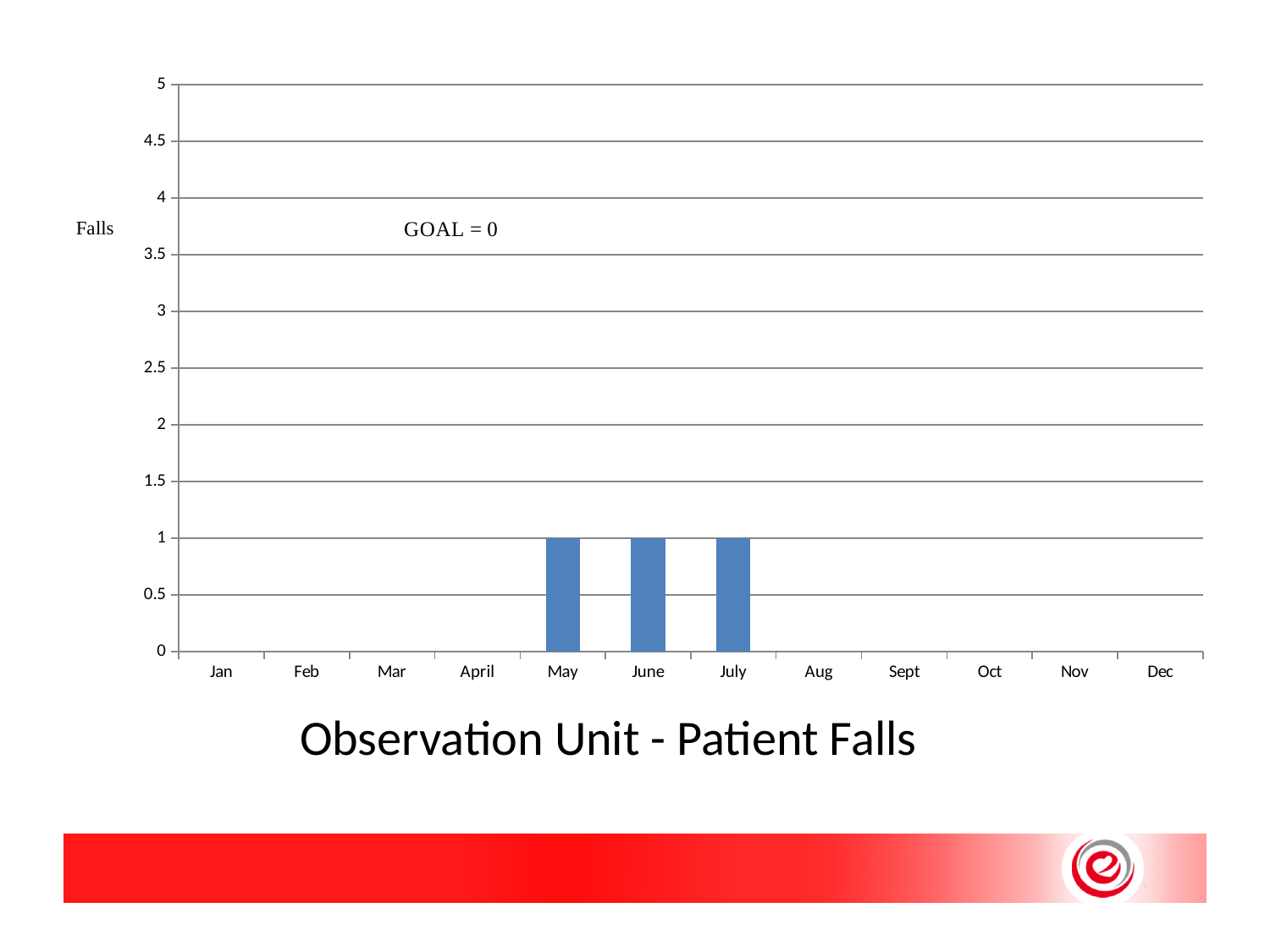
How many months in the chart have a bar plotted? 3 What is the title of the chart? Observation Unit - Patient Falls Which is larger, the value for May or the value for Jan? May What is the highest value shown on the y axis of the chart? 5 What kind of chart is shown on the slide? bar chart What is the value for July in the chart? 1 Is the value for June greater or less than 2? less What is the difference between the value for July and the value for May? 0 How many months are shown on the x axis of the chart? 12 What is the value for May in the chart? 1 What goal is stated on the chart? GOAL = 0 What is the value for June in the chart? 1